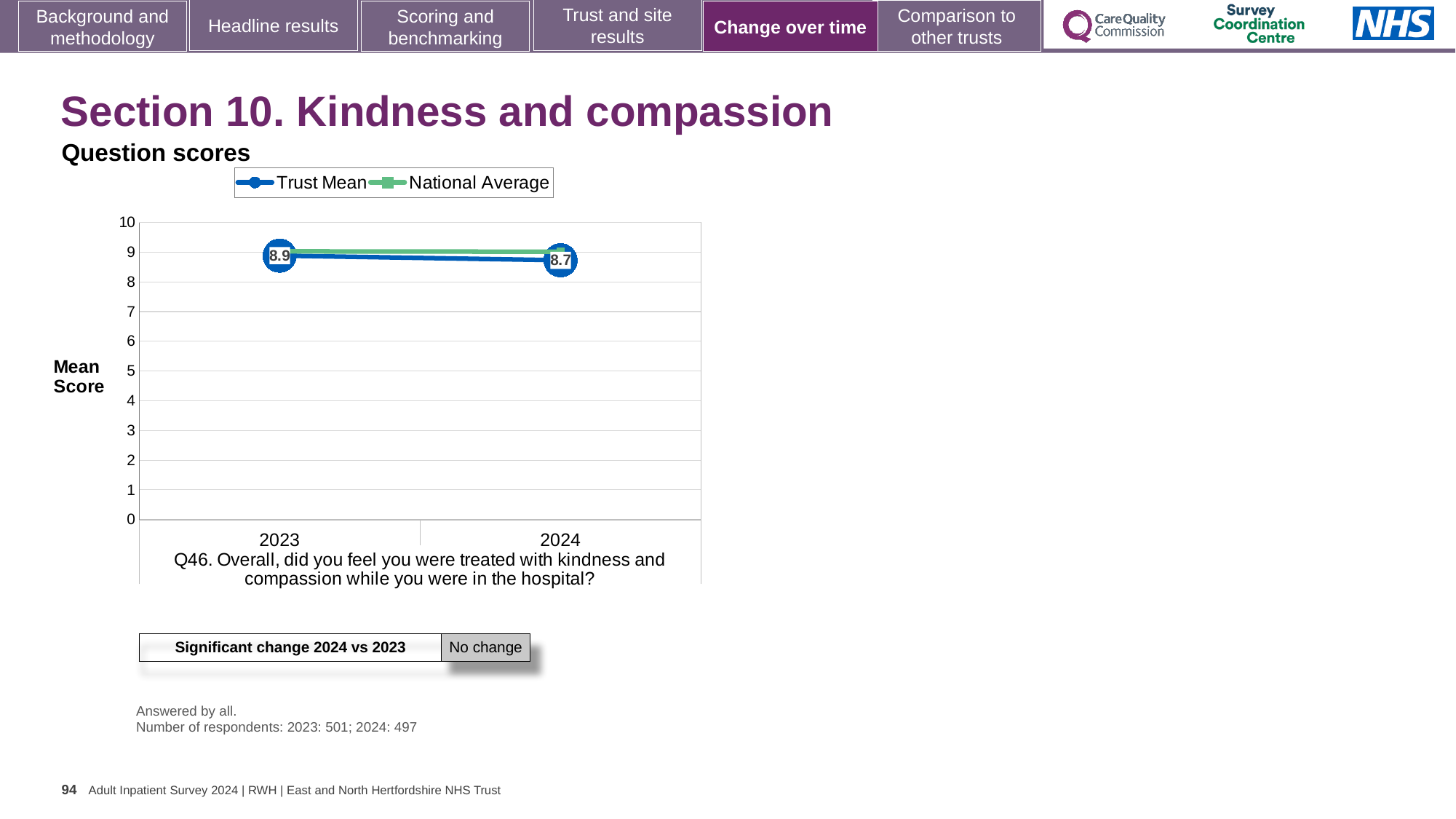
What is the Trust Mean score for 2024? 8.7 How many years are plotted on the x axis? 2 What kind of chart is shown? line chart Does the Trust Mean rise or fall from 2023 to 2024? fall How many series does the legend list? 2 What are the two series named in the legend? Trust Mean and National Average In which year is the Trust Mean score lowest? 2024 Is the National Average value for 2024 greater or less than 5? greater What is the label on the y axis? Mean Score What is the Trust Mean score for 2023? 8.9 Which year has the higher Trust Mean score, 2023 or 2024? 2023 By how much did the Trust Mean score change from 2023 to 2024? 0.2